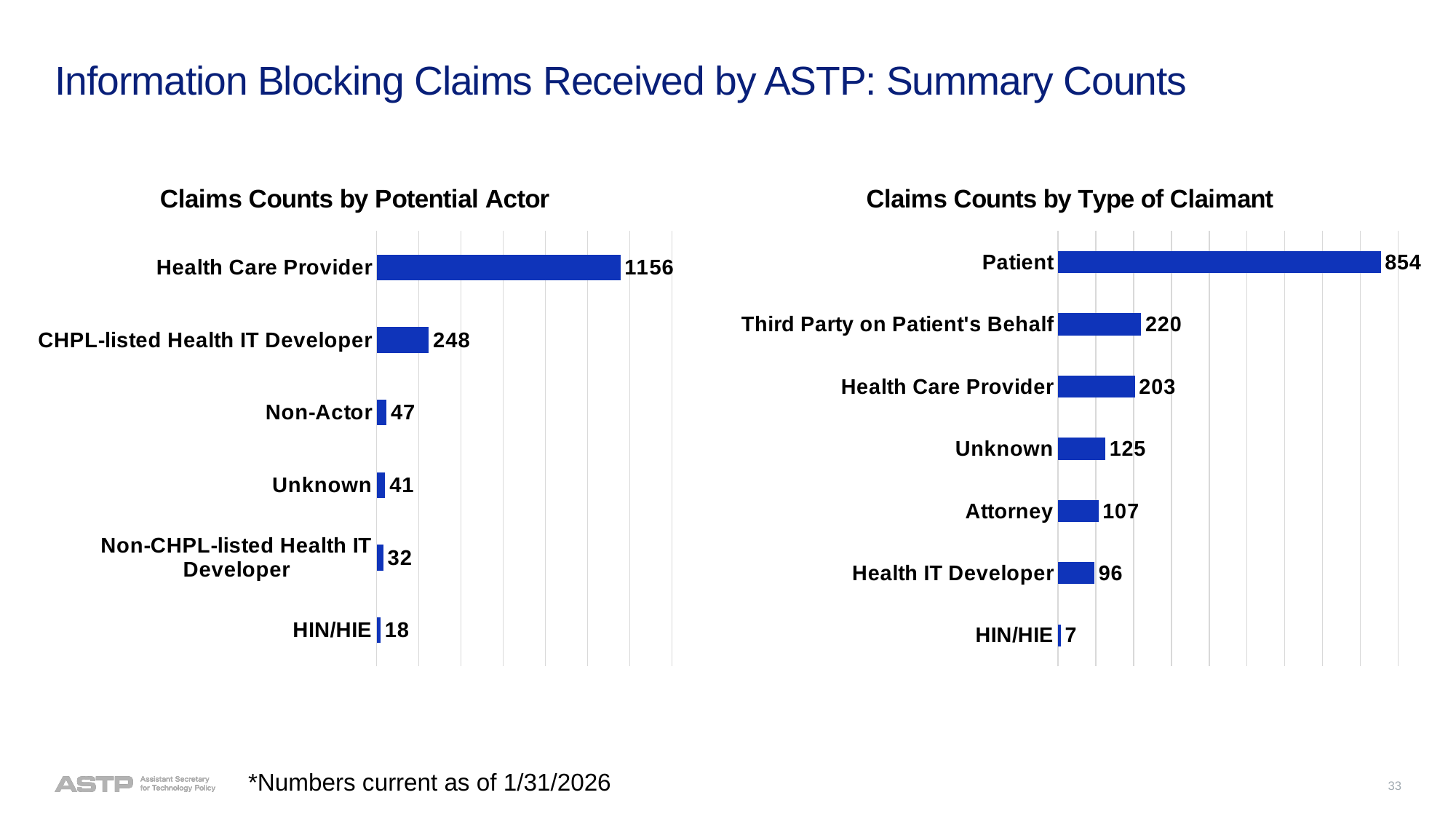
In the 'Claims Counts by Potential Actor' chart, what is the value for CHPL-listed Health IT Developer? 248 In the 'Claims Counts by Potential Actor' chart, what is the difference between Non-Actor and Unknown? 6 In the 'Claims Counts by Potential Actor' chart, which category has the lowest value? HIN/HIE In the 'Claims Counts by Type of Claimant' chart, what is the difference between Unknown and Health IT Developer? 29 In the 'Claims Counts by Type of Claimant' chart, how many categories are shown? 7 In the 'Claims Counts by Potential Actor' chart, what is the value for Health Care Provider? 1156 In the 'Claims Counts by Type of Claimant' chart, which is larger: Third Party on Patient's Behalf or Health Care Provider? Third Party on Patient's Behalf In the 'Claims Counts by Type of Claimant' chart, what is the value for Patient? 854 In the 'Claims Counts by Potential Actor' chart, how many categories are shown? 6 In the 'Claims Counts by Type of Claimant' chart, what is the value for Attorney? 107 In the 'Claims Counts by Type of Claimant' chart, which category has the highest value? Patient What kind of chart is the 'Claims Counts by Potential Actor' chart? Bar chart